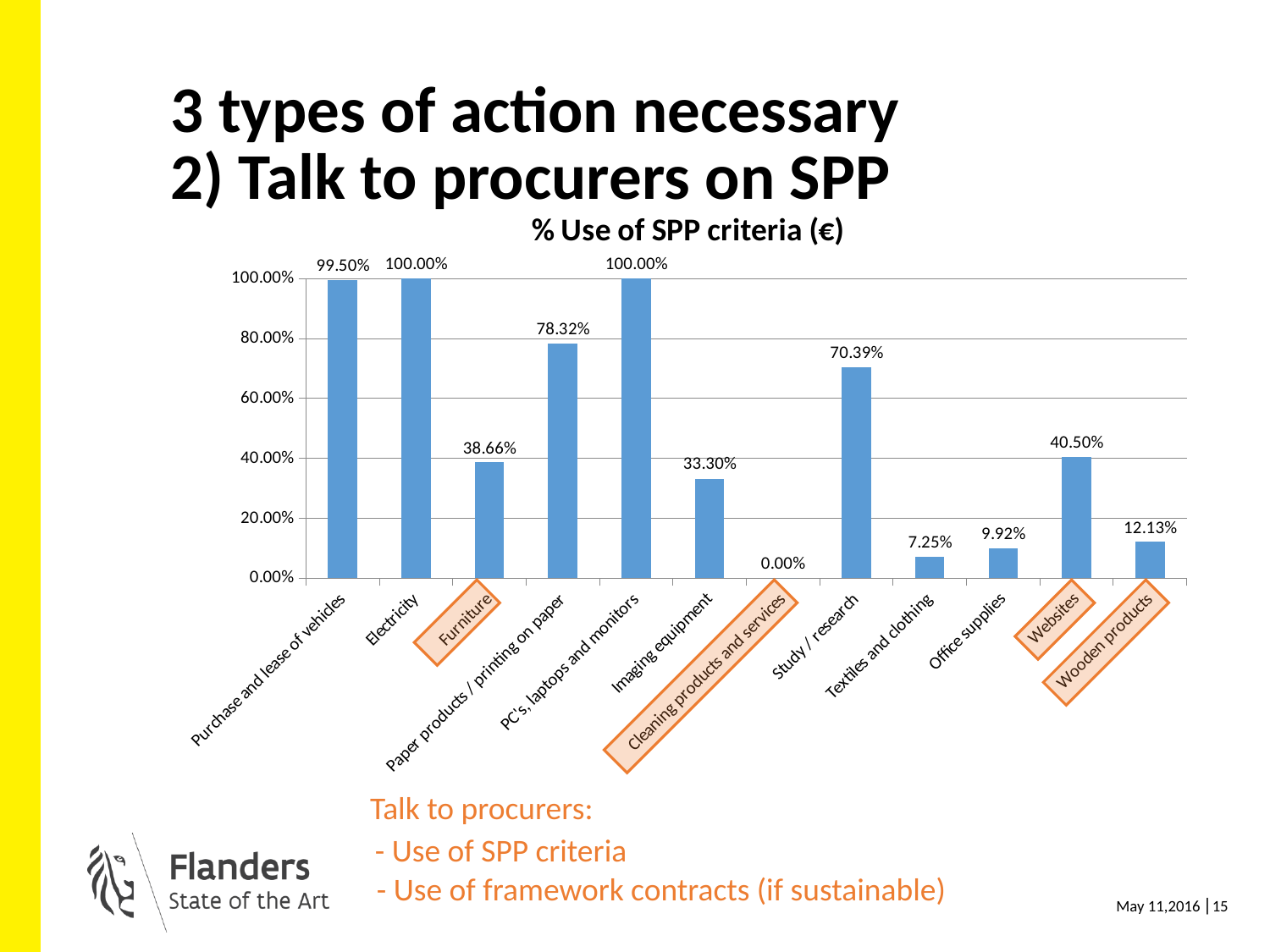
How many categories are shown on the x axis of the chart? 12 What is the value for Textiles and clothing? 7.25% What is the value for Websites? 40.50% Is the value for Purchase and lease of vehicles greater or less than 80.00%? greater What is the difference between the values for Paper products / printing on paper and Imaging equipment? 45.02% What is the difference between the values for Wooden products and Office supplies? 2.21% What percentage is shown for Study / research? 70.39% What is the value for Furniture in the '% Use of SPP criteria (€)' chart? 38.66% Which category has the lowest value in the chart? Cleaning products and services What is the title of the chart? % Use of SPP criteria (€) What kind of chart is shown on the slide? Bar chart Which is larger, the value for Websites or the value for Furniture? Websites